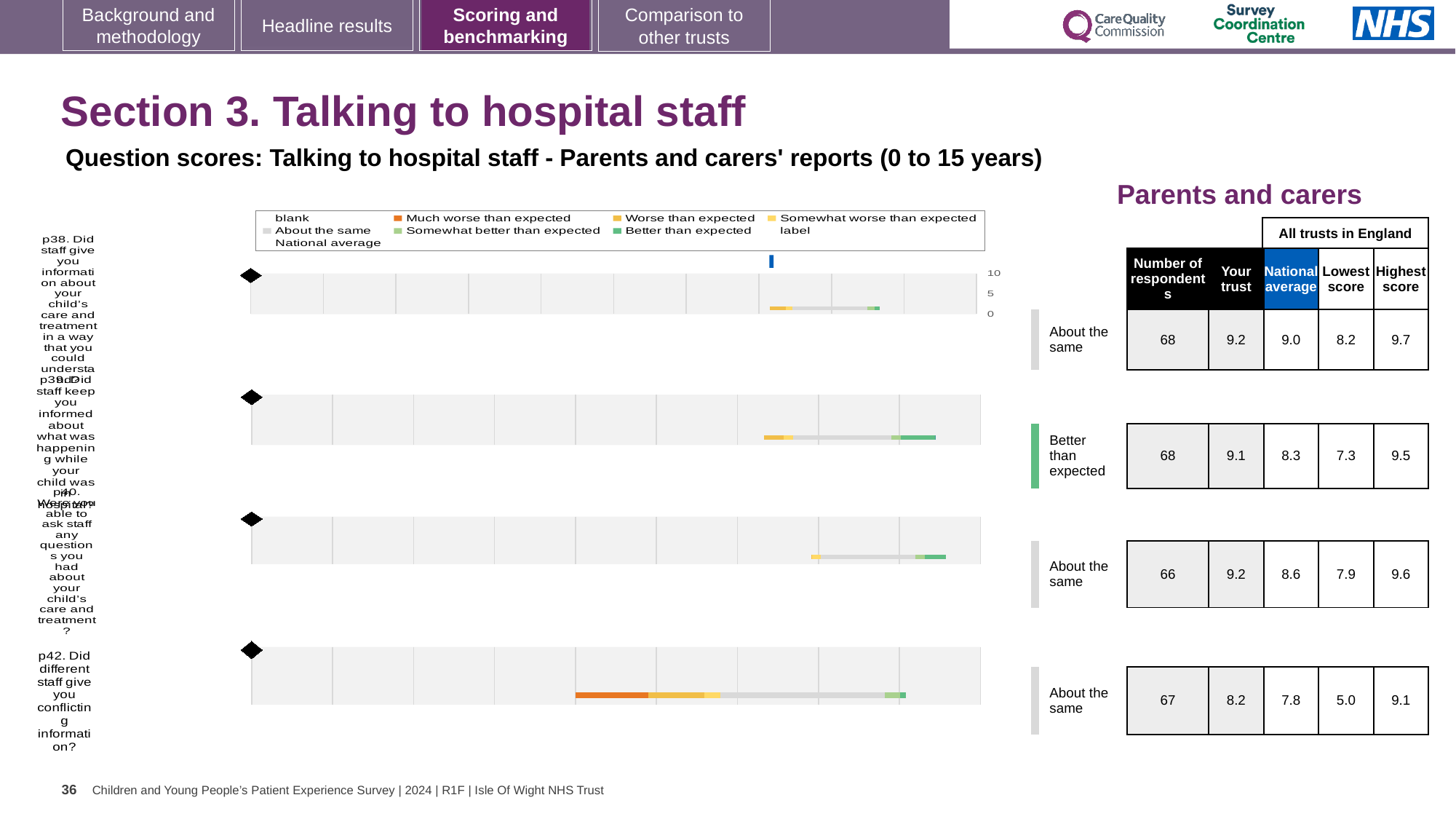
In the table next to the p42 chart, what is the Lowest score among all trusts in England? 5.0 For p42, what is the difference between the 'Your trust' score and the National average? 0.4 How many question charts (p38, p39, p40, p42) are shown on the slide? 4 For p40, which is larger: the 'Your trust' score or the National average? Your trust What kind of chart is used to show the benchmarking results for each question on this slide? bar chart Which question has the lowest 'Your trust' score in the table? p42 In the table next to the p39 chart, what is the National average score? 8.3 Which question's chart is rated 'Better than expected'? p39 In the table next to the p38 chart, what is the 'Your trust' score? 9.2 How many of the question charts are rated 'About the same'? 3 How many respondents are listed for the p40 chart? 66 In the chart legend, what colour represents 'Much worse than expected'? orange